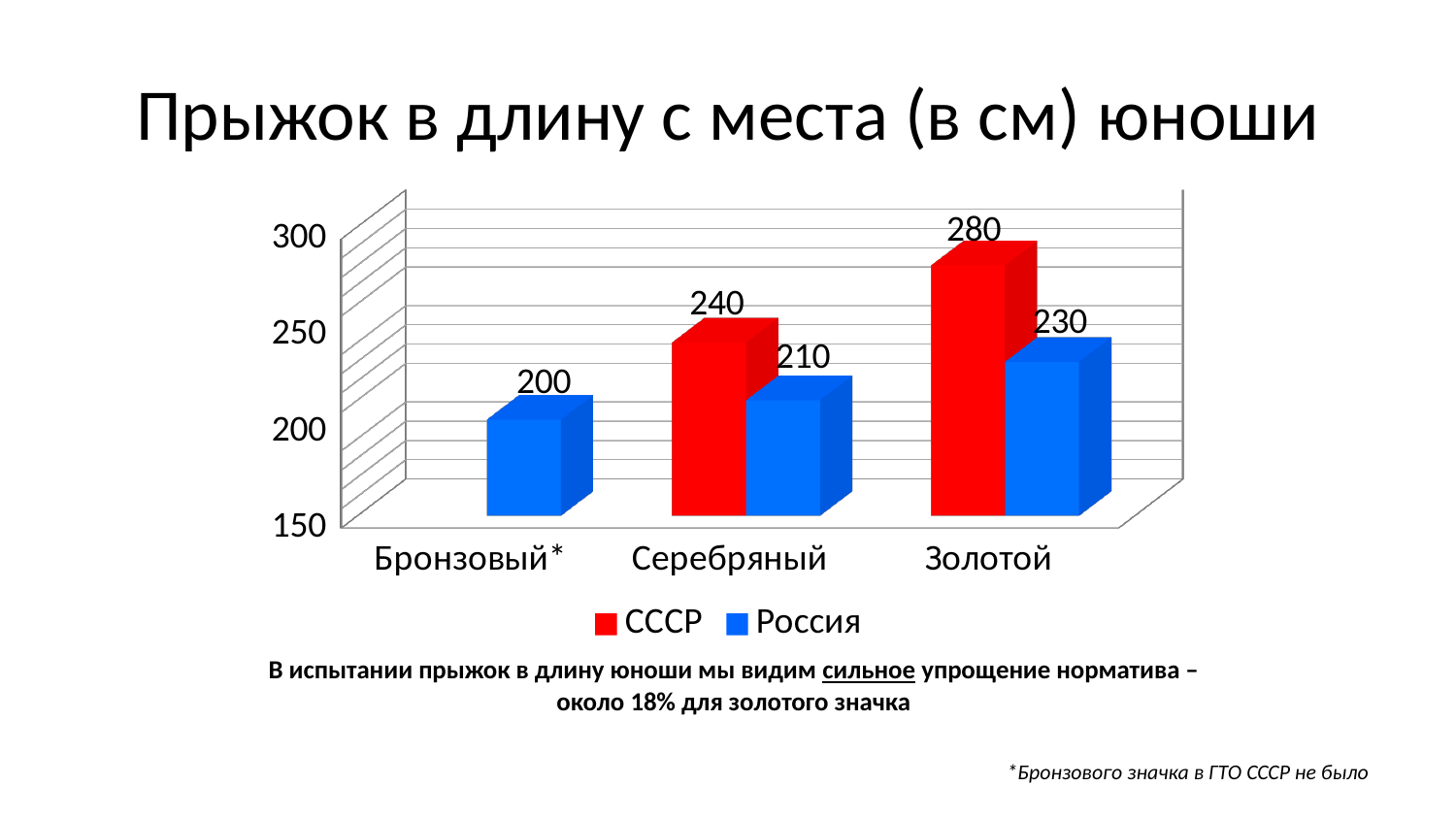
How many series does the legend list? 2 What is the title of the chart? Прыжок в длину с места (в см) юноши What is the value for Россия in the Серебряный category? 210 What is the value for Россия in the Бронзовый* category? 200 Which category has the highest value for the Россия series? Золотой What kind of chart is shown on the slide? Bar chart Which category has the lowest value for the Россия series? Бронзовый* What is the value for СССР in the Серебряный category? 240 Which is larger in the Серебряный category: the СССР value or the Россия value? СССР What is the value for СССР in the Золотой category? 280 How many categories are shown on the x axis? 3 What is the difference between the СССР and Россия values in the Золотой category? 50